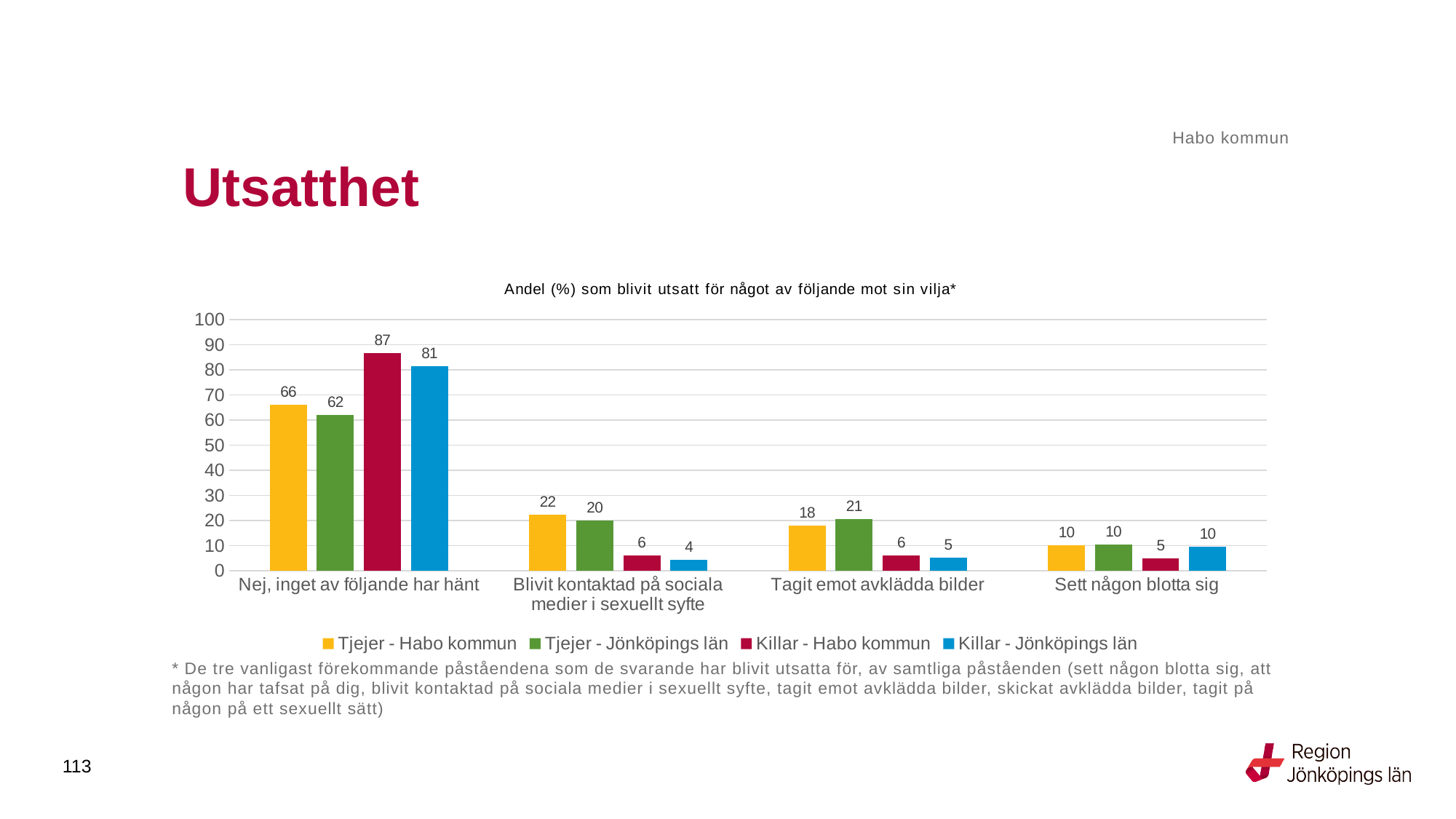
What is the value for Killar - Jönköpings län in the category "Blivit kontaktad på sociala medier i sexuellt syfte"? 4 Which series has the highest value in the category "Nej, inget av följande har hänt"? Killar - Habo kommun How many series does the legend list? 4 How many categories are shown on the x axis? 4 What is the title of the chart? Andel (%) som blivit utsatt för något av följande mot sin vilja* Which series has the lowest value in the category "Sett någon blotta sig"? Killar - Habo kommun Which is larger in the category "Tagit emot avklädda bilder": Tjejer - Habo kommun or Tjejer - Jönköpings län? Tjejer - Jönköpings län What is the difference between Tjejer - Habo kommun and Killar - Habo kommun in the category "Blivit kontaktad på sociala medier i sexuellt syfte"? 16 What kind of chart is shown on the slide? Bar chart Which colour represents Tjejer - Habo kommun in the legend? Yellow What is the value for Tjejer - Jönköpings län in the category "Tagit emot avklädda bilder"? 21 What is the value for Killar - Habo kommun in the category "Nej, inget av följande har hänt"? 87